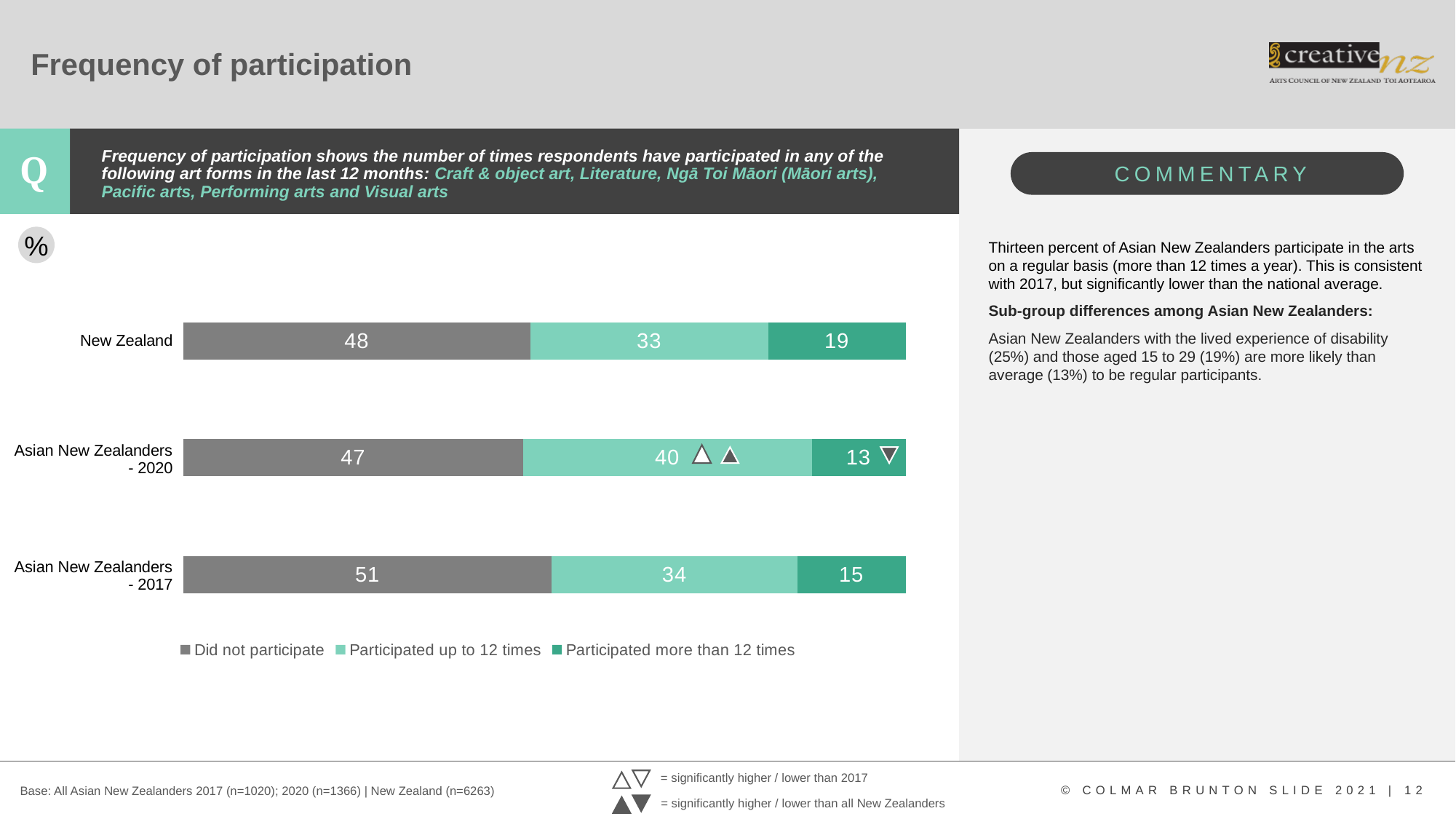
What is the value for 'Participated up to 12 times' for Asian New Zealanders - 2020? 40 What percentage of New Zealand respondents did not participate? 48 What kind of chart is shown on the slide? Stacked bar chart What is the total of the stacked bar for Asian New Zealanders - 2017? 100 Which is larger: 'Participated up to 12 times' for Asian New Zealanders - 2020 or for Asian New Zealanders - 2017? Asian New Zealanders - 2020 Which category has the highest 'Did not participate' value? Asian New Zealanders - 2017 Which category has the lowest 'Participated more than 12 times' value? Asian New Zealanders - 2020 What is the difference between the 'Participated more than 12 times' values for New Zealand and Asian New Zealanders - 2020? 6 How many series does the legend list? 3 Which series is shown in dark grey in the legend? Did not participate What is the value for 'Participated more than 12 times' for Asian New Zealanders - 2017? 15 How many categories are shown on the chart? 3